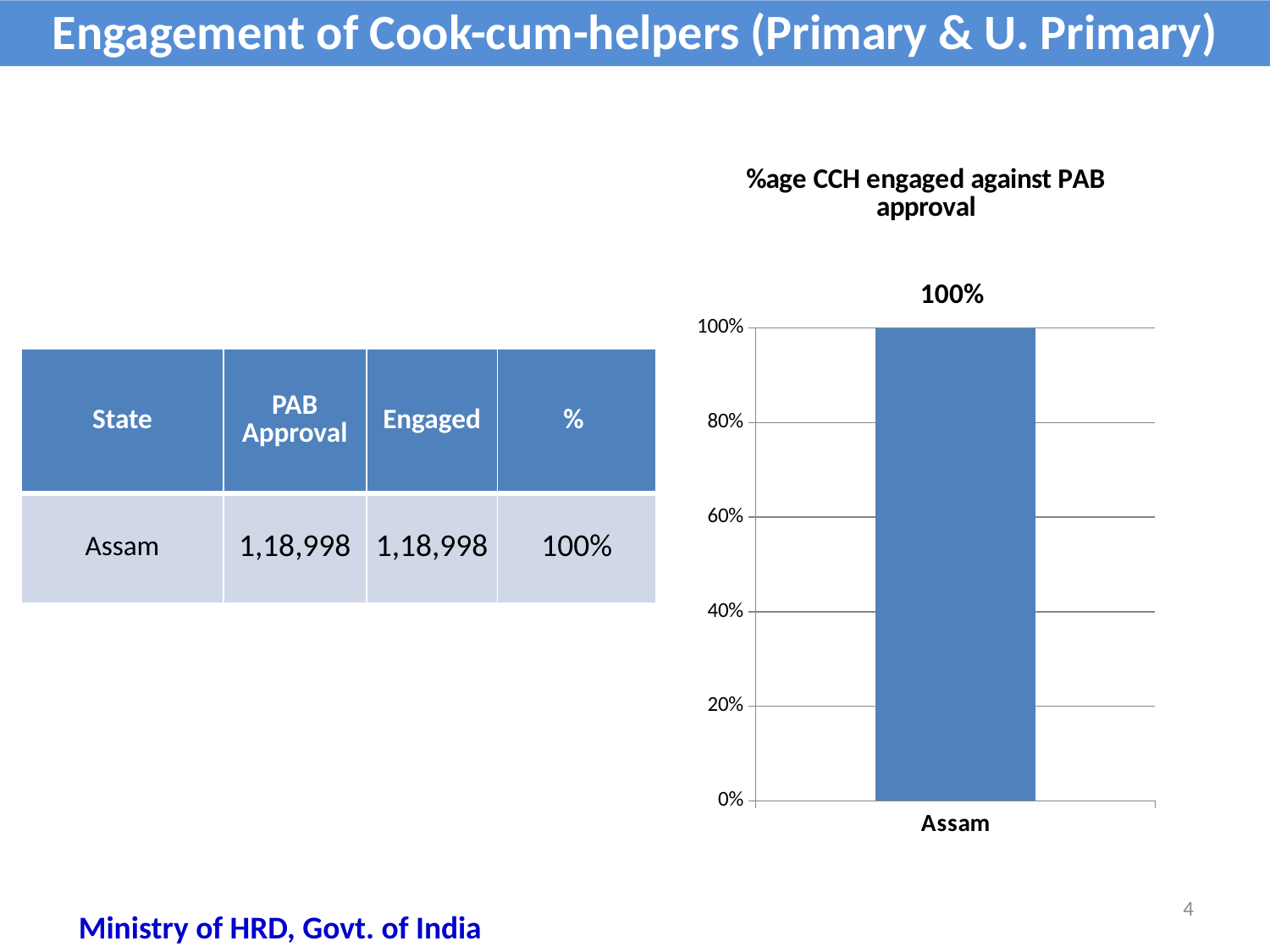
What is the value for Assam in the chart? 100% What kind of chart is shown on the slide? bar chart Is the value for Assam greater or less than 80%? greater Which state is shown on the x axis of the chart? Assam How many categories are plotted in the chart? 1 What is the title of the chart? %age CCH engaged against PAB approval What is the highest value shown on the chart's y axis? 100%